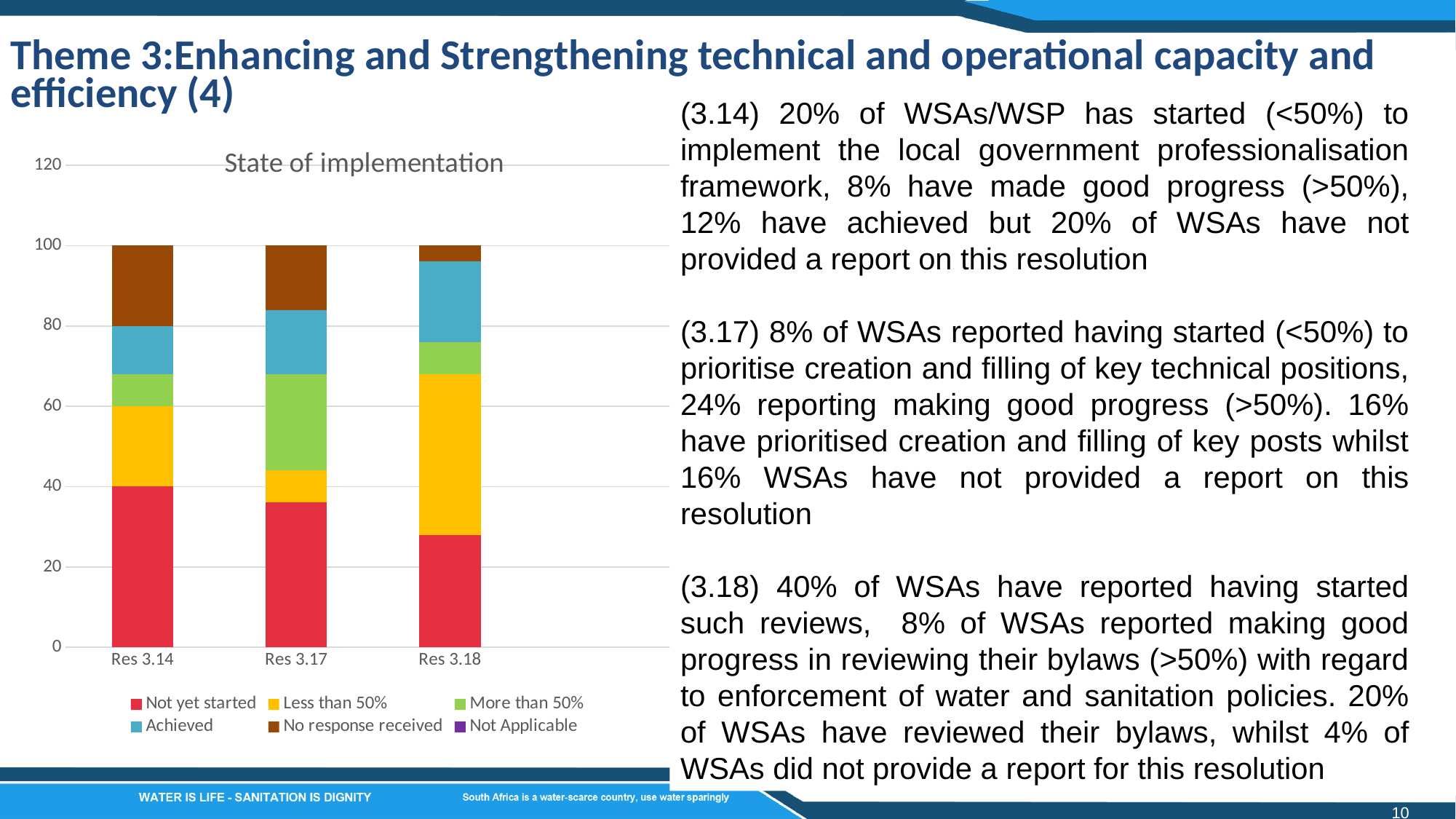
What type of chart is shown on the slide? Stacked bar chart Which resolution has the largest 'Not yet started' segment? Res 3.14 What is the total height of the stacked bar for Res 3.17? 100 How many categories (resolutions) are shown on the x axis of the chart? 3 Which resolution has the largest 'More than 50%' segment? Res 3.17 Which is larger: the 'Not yet started' segment for Res 3.14 or for Res 3.18? Res 3.14 Is the 'Less than 50%' segment for Res 3.18 greater or less than 20? greater Which resolution has the smallest 'No response received' segment? Res 3.18 What is the title of the chart? State of implementation How many series does the chart legend list? 6 What is the value of the 'Not yet started' segment for Res 3.14? 40 Is the 'Not yet started' value for Res 3.18 greater or less than 40? less